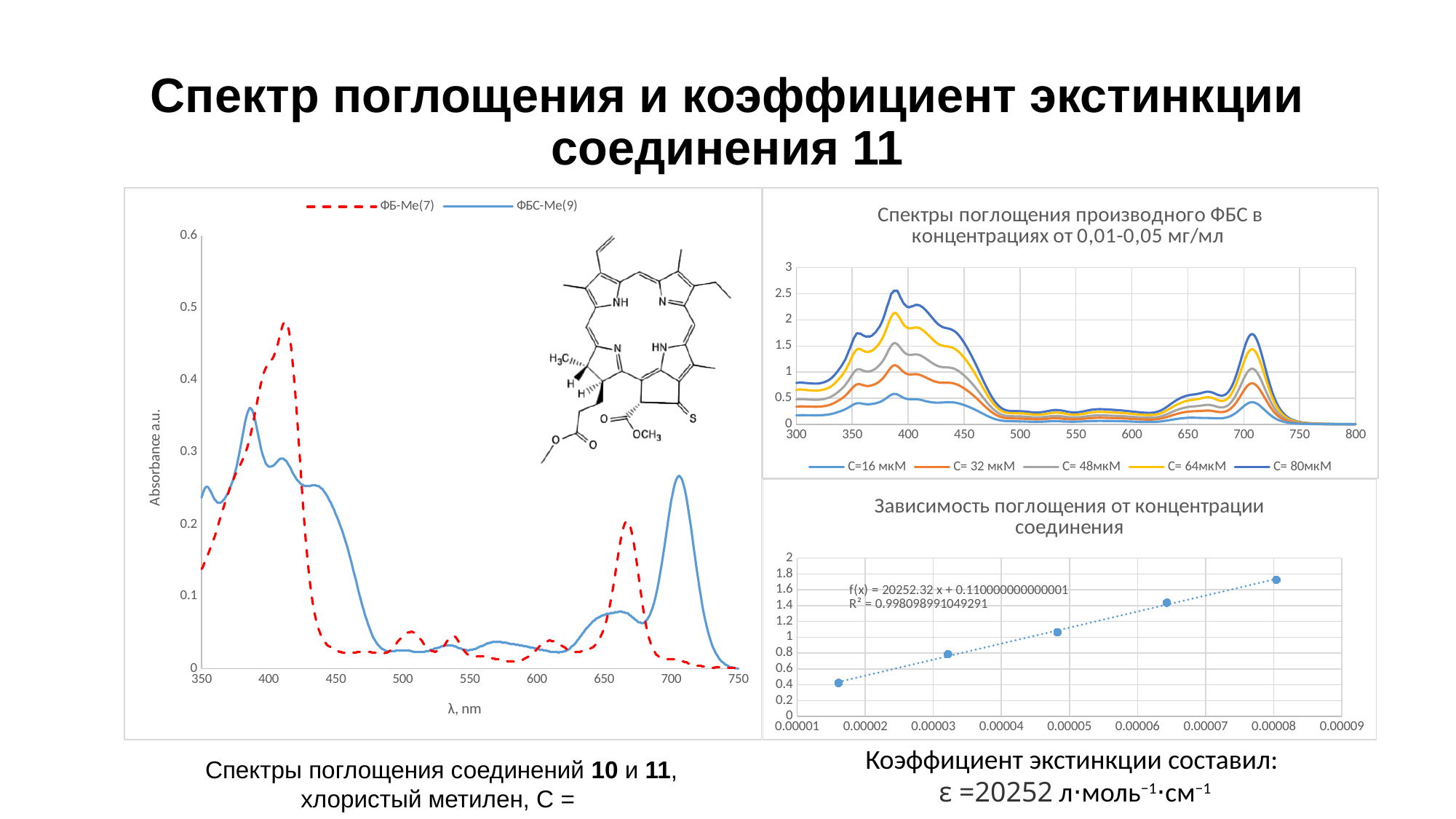
In the left chart, is the peak value of ФБС-Me(9) near 705 nm greater or less than 0.2? greater In the left chart, which series is drawn as a red dashed line? ФБ-Me(7) In the chart 'Спектры поглощения производного ФБС в концентрациях от 0,01-0,05 мг/мл', is the peak of the C=16 мкМ series near 390 nm greater or less than 1? less How many series does the legend of the left chart list? 2 In the chart 'Спектры поглощения производного ФБС в концентрациях от 0,01-0,05 мг/мл', which concentration series has the highest curve? C= 80мкМ How many series does the legend list in the chart titled 'Спектры поглощения производного ФБС в концентрациях от 0,01-0,05 мг/мл'? 5 In the chart 'Зависимость поглощения от концентрации соединения', do the values rise or fall as concentration increases along the x axis? rise What kind of chart is the left chart showing the absorption spectra of compounds 10 and 11? line chart In the left chart, which series has the higher peak around 410 nm, ФБ-Me(7) or ФБС-Me(9)? ФБ-Me(7) How many data points are plotted in the chart titled 'Зависимость поглощения от концентрации соединения'? 5 What is the trendline equation shown in the chart 'Зависимость поглощения от концентрации соединения'? f(x) = 20252.32 x + 0.110000000000001 In the left chart, is the peak value of ФБ-Me(7) near 410 nm greater or less than 0.4? greater